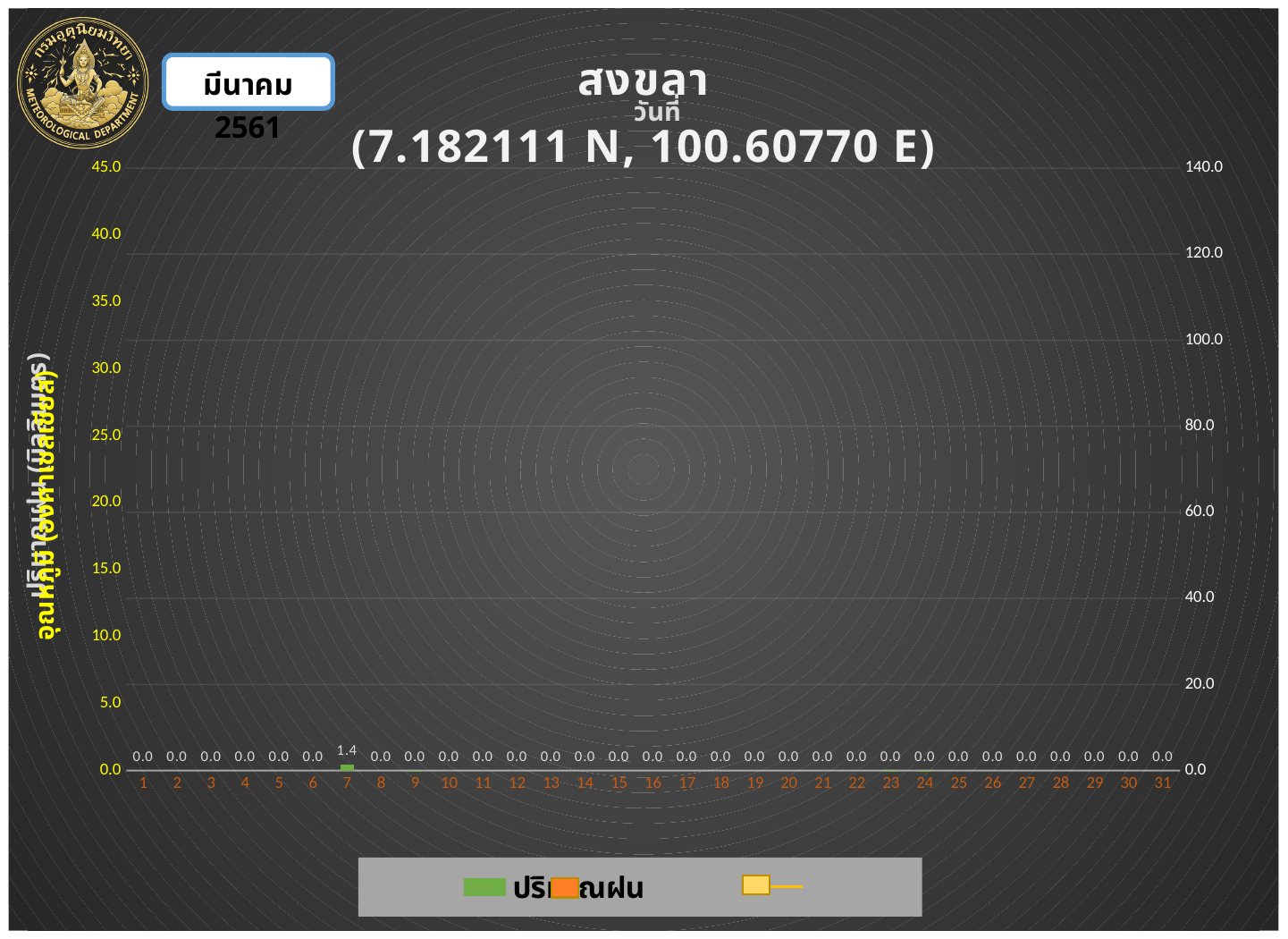
What is the rainfall value shown for day 31? 0.0 Is the rainfall value for day 7 greater or less than 5.0? less What is the rainfall value shown for day 1? 0.0 What is the highest tick value on the right vertical axis? 140.0 What is the difference between the rainfall value for day 7 and the value for day 8? 1.4 Which day has the highest rainfall value? 7 Which has the larger rainfall value, day 7 or day 15? Day 7 What is the highest tick value on the left vertical axis? 45.0 What is the rainfall value shown for day 7? 1.4 What kind of chart is shown on the slide? Bar chart How many days are shown along the x axis? 31